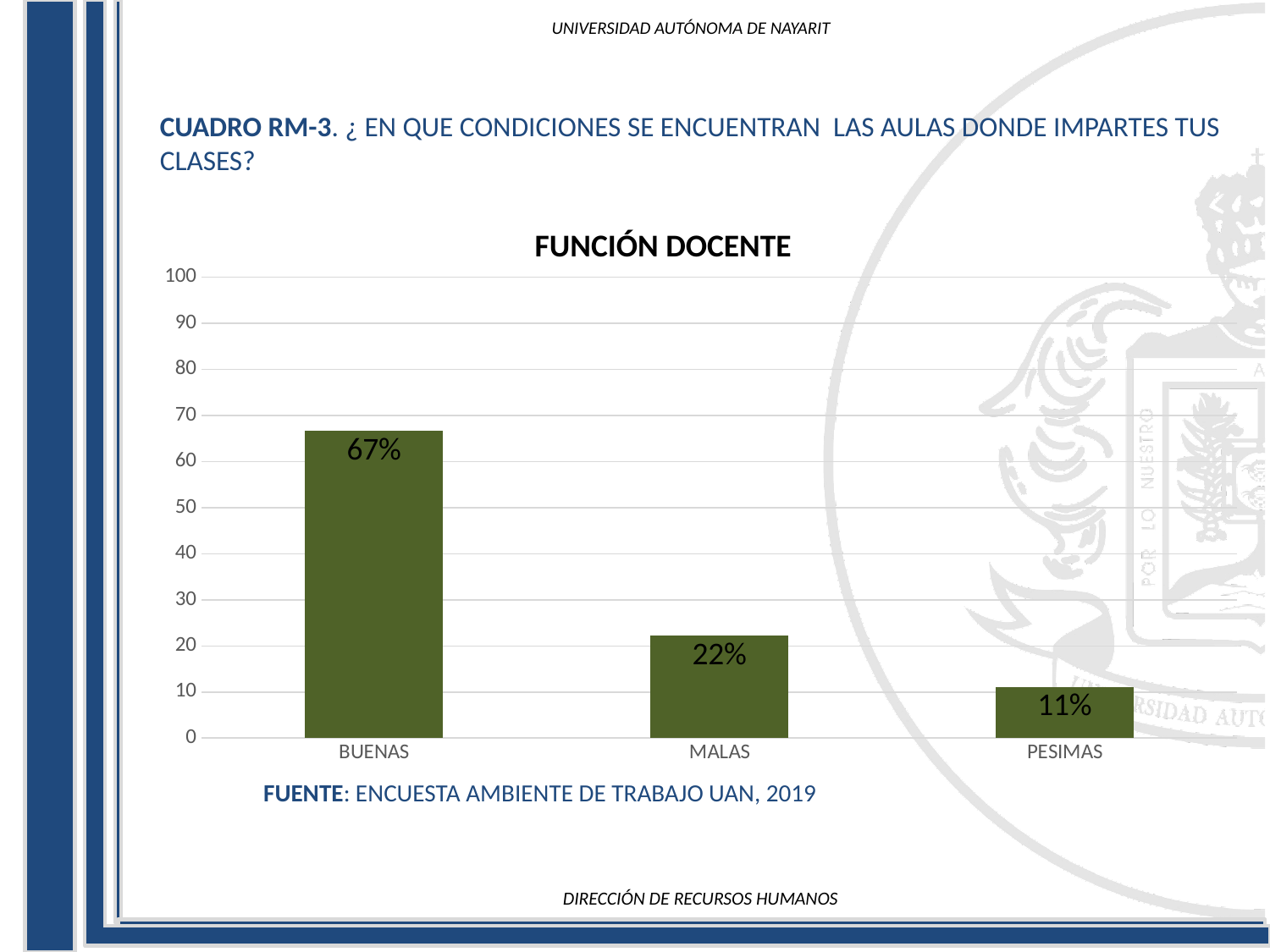
What kind of chart is shown? bar chart What is the value for PESIMAS? 11% What is the difference between the values for BUENAS and MALAS? 45% Which category has the highest value? BUENAS What is the title of the chart? FUNCIÓN DOCENTE What is the difference between the values for MALAS and PESIMAS? 11% How many categories are shown on the x axis? 3 Which is larger, the value for MALAS or the value for PESIMAS? MALAS Which category has the lowest value? PESIMAS What is the value for BUENAS? 67% What is the value for MALAS? 22% Is the value for BUENAS greater or less than 60? greater